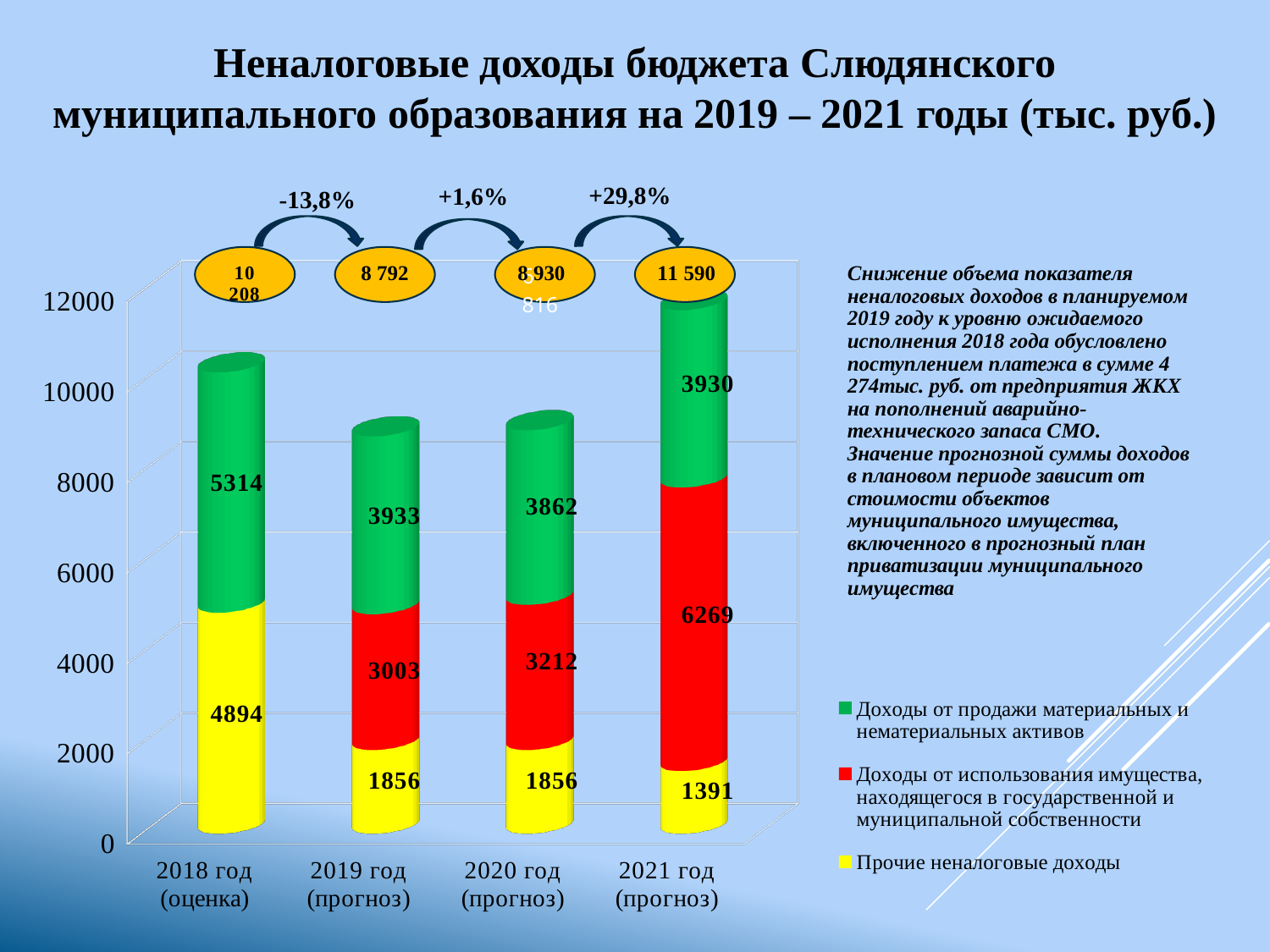
How many years (categories) are shown on the x axis? 4 What is the value of Прочие неналоговые доходы for 2018 год (оценка)? 4894 What kind of chart is shown on the slide? Stacked bar chart How many series does the legend list? 3 By how much does the red series value for 2021 год exceed the red series value for 2020 год? 3057 Which is larger: the green series value for 2019 год or for 2020 год? 2019 год What is the value of the red series (Доходы от использования имущества) for 2019 год (прогноз)? 3003 Which year has the lowest total non-tax revenue? 2019 год (прогноз) What is the value of Прочие неналоговые доходы for 2021 год (прогноз)? 1391 What is the total shown above the bar for 2021 год (прогноз)? 11 590 Which year has the highest total non-tax revenue? 2021 год (прогноз) What is the value of the green series (Доходы от продажи материальных и нематериальных активов) for 2021 год (прогноз)? 3930